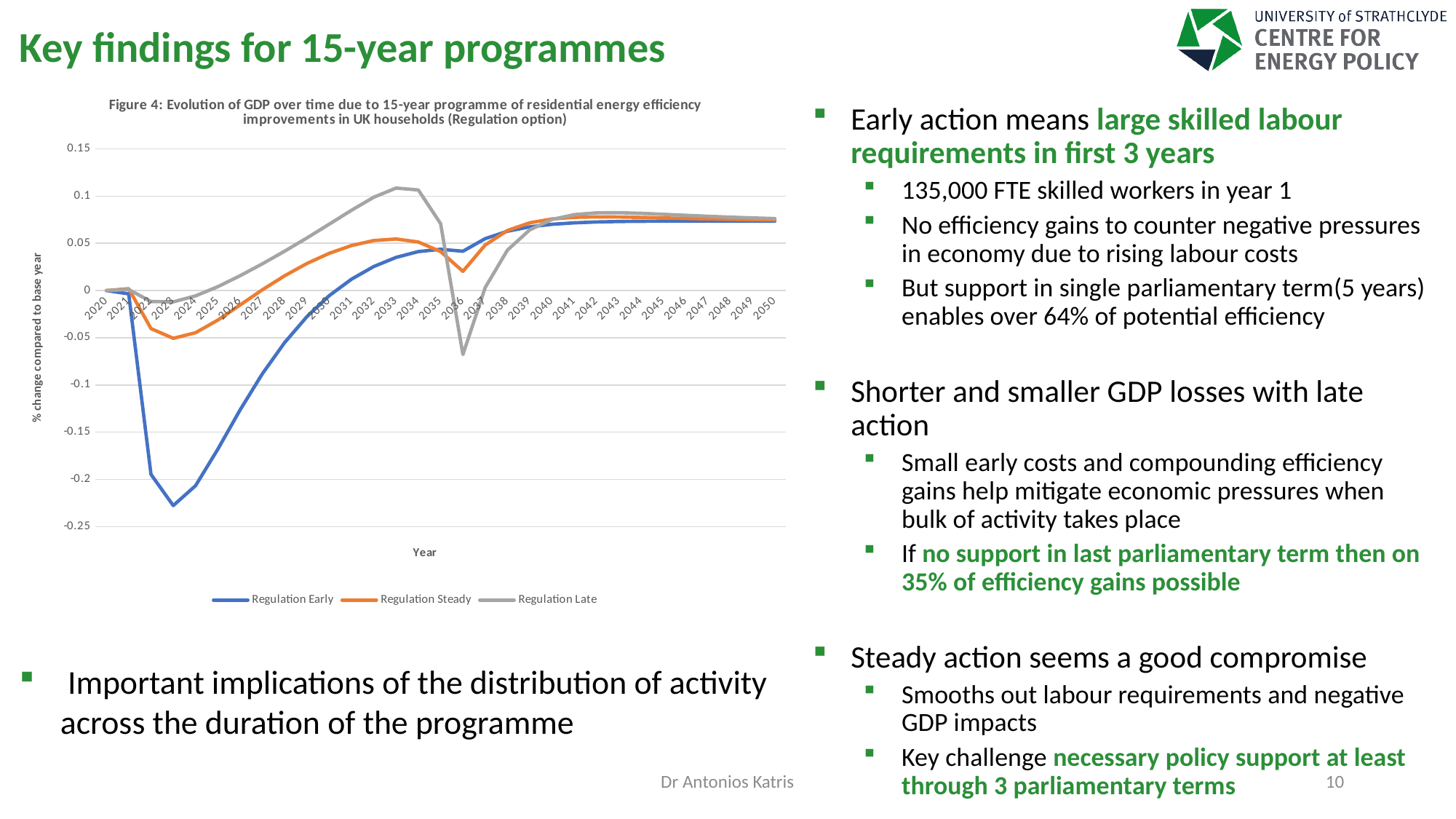
What is the label of the vertical axis? % change compared to base year Is the value for Regulation Steady in 2023 greater or less than -0.1? greater Which series reaches the lowest value on the chart? Regulation Early Does the Regulation Early series rise or fall between 2023 and 2040? Rises Which series has the highest value in 2033? Regulation Late What colour is the Regulation Late line? Grey How many years are plotted along the x axis? 31 What kind of chart is shown on the slide? Line chart Is the value for Regulation Late in 2036 greater or less than -0.05? less In 2023, which is larger: Regulation Early or Regulation Steady? Regulation Steady Is the value for Regulation Early in 2023 greater or less than -0.2? less How many series does the legend list? 3